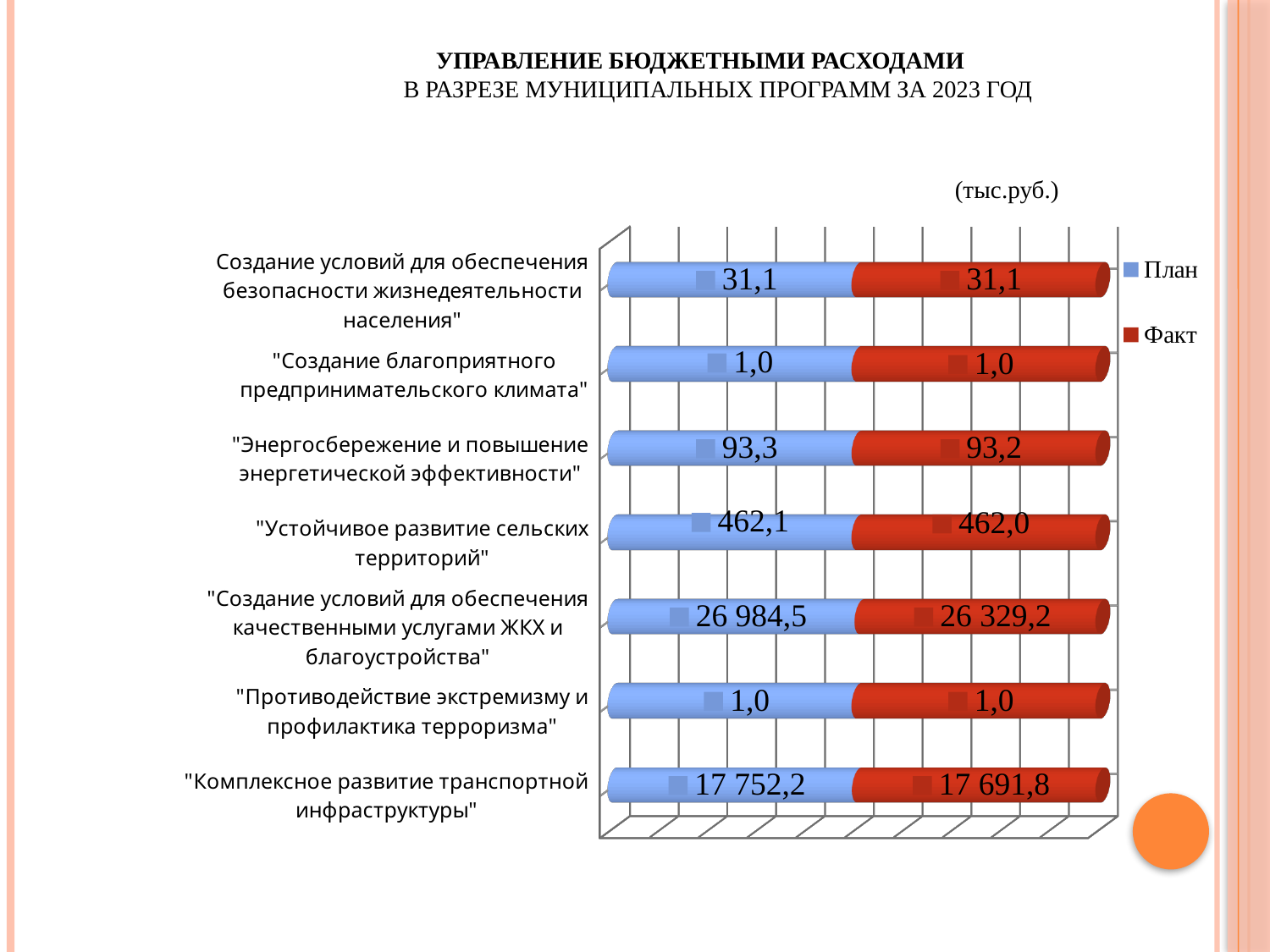
What is the План value for "Создание условий для обеспечения качественными услугами ЖКХ и благоустройства"? 26 984,5 Which category has the highest План value? "Создание условий для обеспечения качественными услугами ЖКХ и благоустройства" What is the Факт value for "Комплексное развитие транспортной инфраструктуры"? 17 691,8 Which colour represents the Факт series in the legend? red What is the difference between the План and Факт values for "Комплексное развитие транспортной инфраструктуры"? 60,4 What unit of measurement is indicated above the chart? тыс.руб. How many categories (municipal programs) are shown in the chart? 7 What is the План value for "Устойчивое развитие сельских территорий"? 462,1 Which is larger for "Создание условий для обеспечения качественными услугами ЖКХ и благоустройства": the План value or the Факт value? План What type of chart is shown on the slide? bar chart How many series does the legend list? 2 What is the Факт value for "Энергосбережение и повышение энергетической эффективности"? 93,2